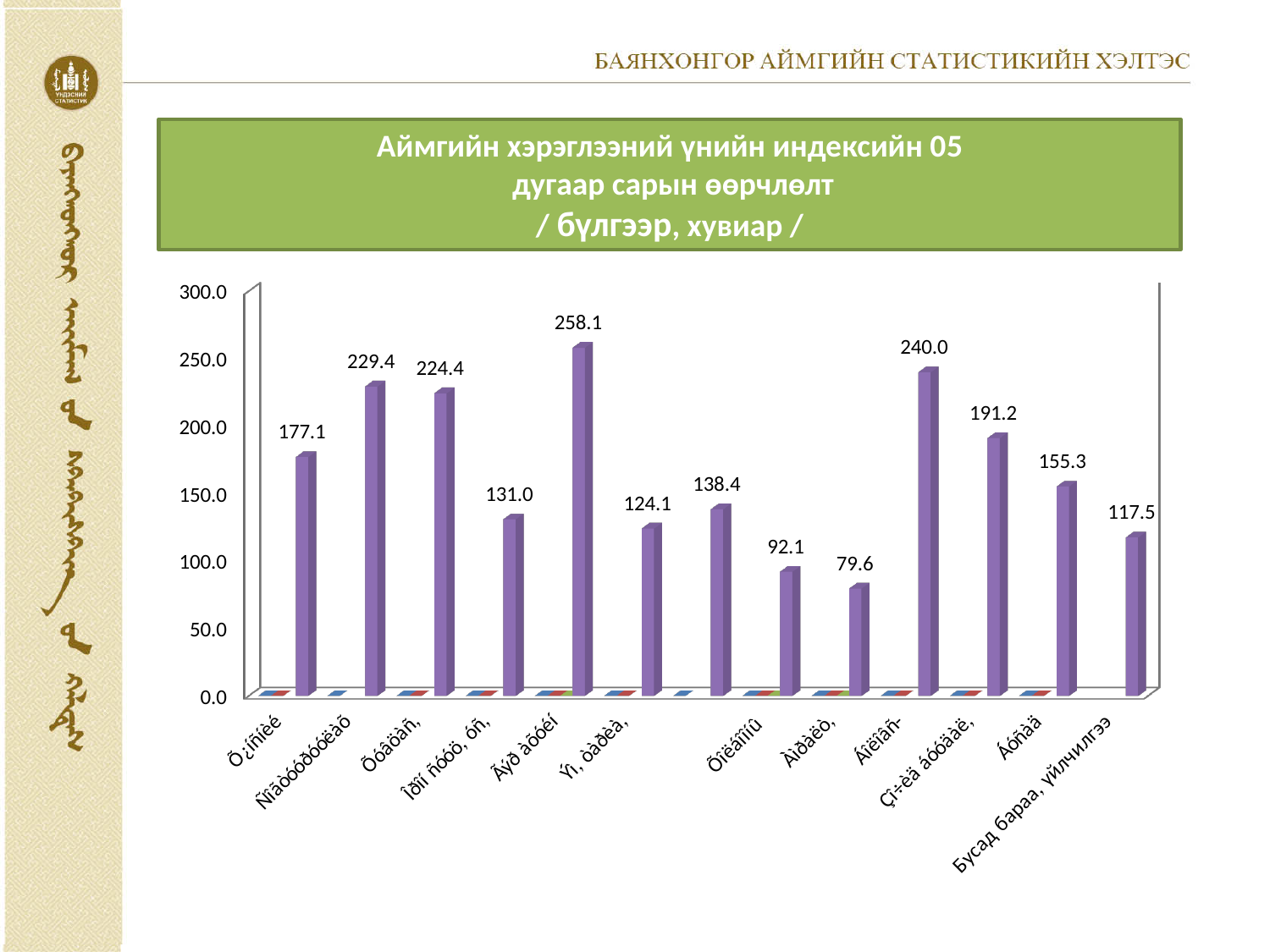
Is the value for "Бусад бараа, үйлчилгээ" greater or less than 150.0? less How many bars are plotted in the chart? 13 Which is larger: the value of the second bar (229.4) or the third bar (224.4)? 229.4 What is the highest value shown in the chart? 258.1 What is the lowest value shown in the chart? 79.6 What is the maximum value shown on the vertical axis of the chart? 300.0 What is the value of the first (leftmost) bar in the chart? 177.1 What kind of chart is shown on the slide? bar chart What is the difference between the highest bar (258.1) and the lowest bar (79.6)? 178.5 What is the value of the bar for "Бусад бараа, үйлчилгээ"? 117.5 What is the value of the second bar from the left? 229.4 What is the difference between the tenth bar (240.0) and the eleventh bar (191.2)? 48.8